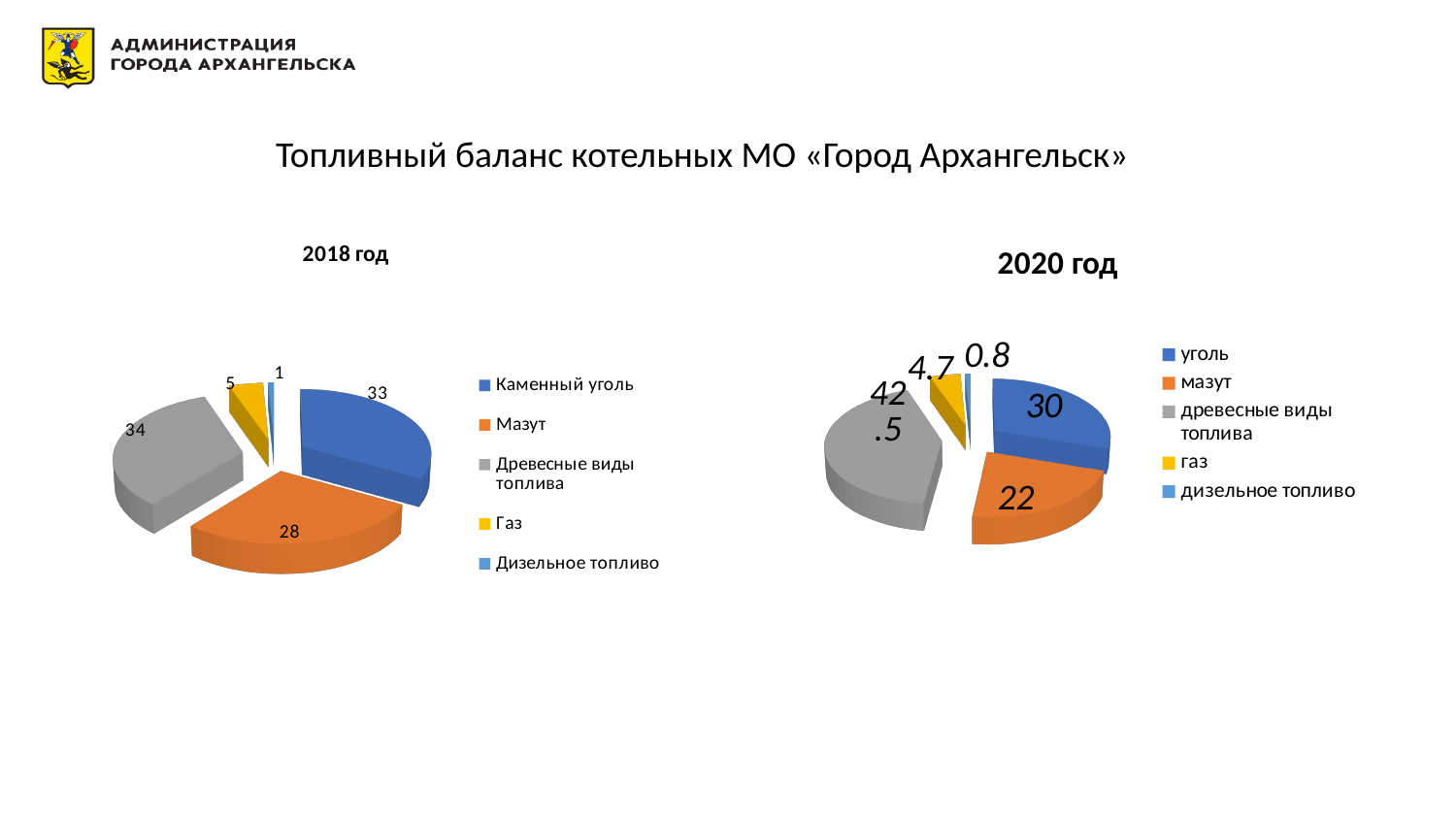
In the "2018 год" chart, which category has the smallest value? Дизельное топливо In the "2018 год" chart, what is the value for Мазут? 28 What is the title of the slide above the two charts? Топливный баланс котельных МО «Город Архангельск» How many categories does the "2020 год" chart show? 5 In the "2020 год" chart, which category has the largest value? древесные виды топлива In the "2018 год" chart, which is larger, the value for Каменный уголь or the value for Мазут? Каменный уголь In the "2018 год" chart, what is the value for Древесные виды топлива? 34 In the "2020 год" chart, what is the value for древесные виды топлива? 42.5 In the "2020 год" chart, what is the value for дизельное топливо? 0.8 In the "2020 год" chart, what is the difference between the values for уголь and мазут? 8 What type of chart is the "2018 год" chart? Pie chart In the "2020 год" chart, what is the value for газ? 4.7